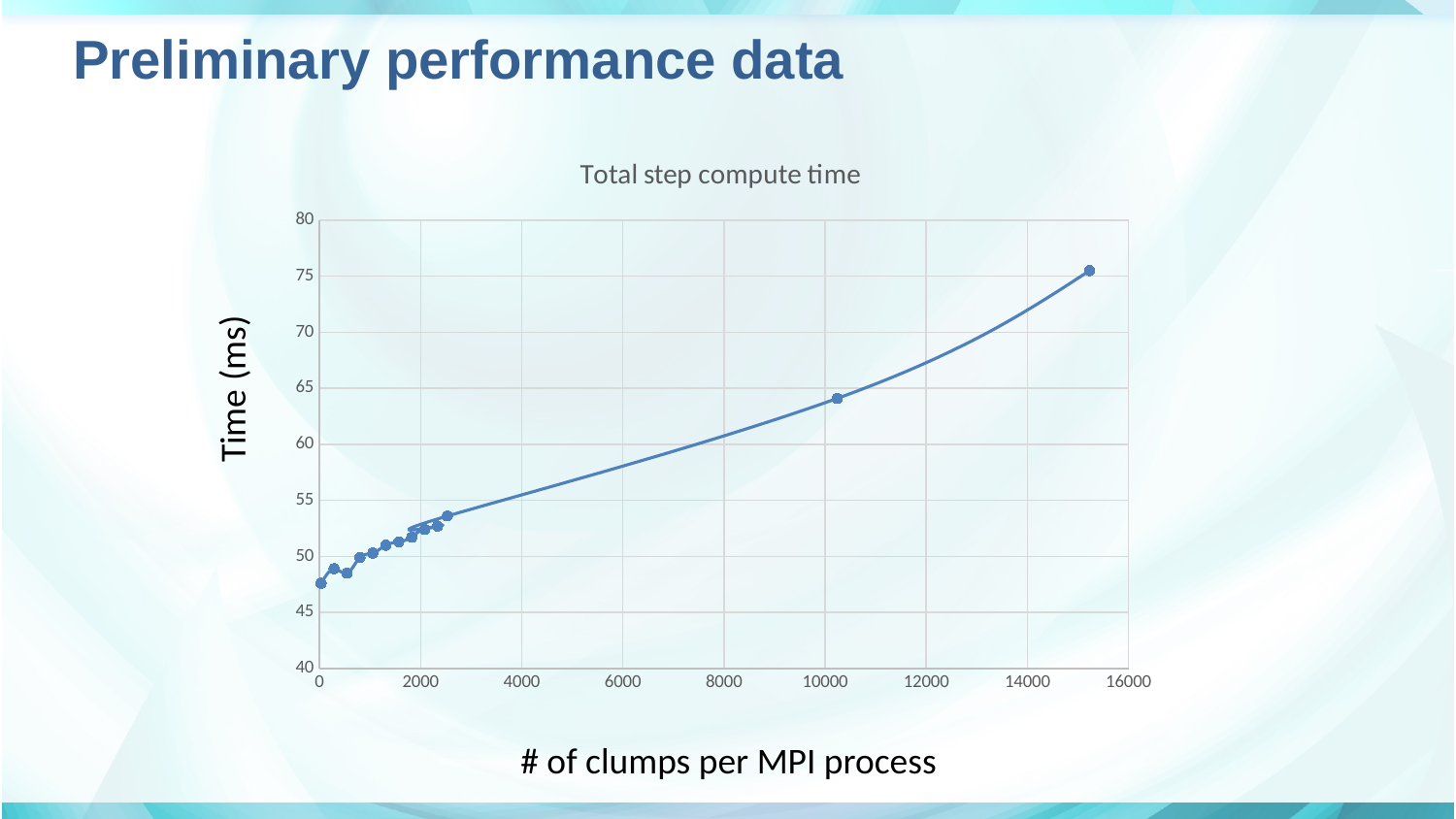
Is the time for the data point at around 10000 clumps per MPI process greater or less than 60 ms? greater What type of chart is shown on the slide? line chart What is the title of the chart? Total step compute time What is the maximum value shown on the y axis? 80 Does the compute time rise or fall as the number of clumps per MPI process increases? rise Is the time for the data point at 0 clumps per MPI process greater or less than 50 ms? less Is the time for the rightmost data point (around 15000 clumps per MPI process) greater or less than 70 ms? greater What is the label of the y axis? Time (ms) Which data point has the highest compute time: the one at around 10000 clumps or the one at around 15000 clumps per MPI process? the one at around 15000 clumps